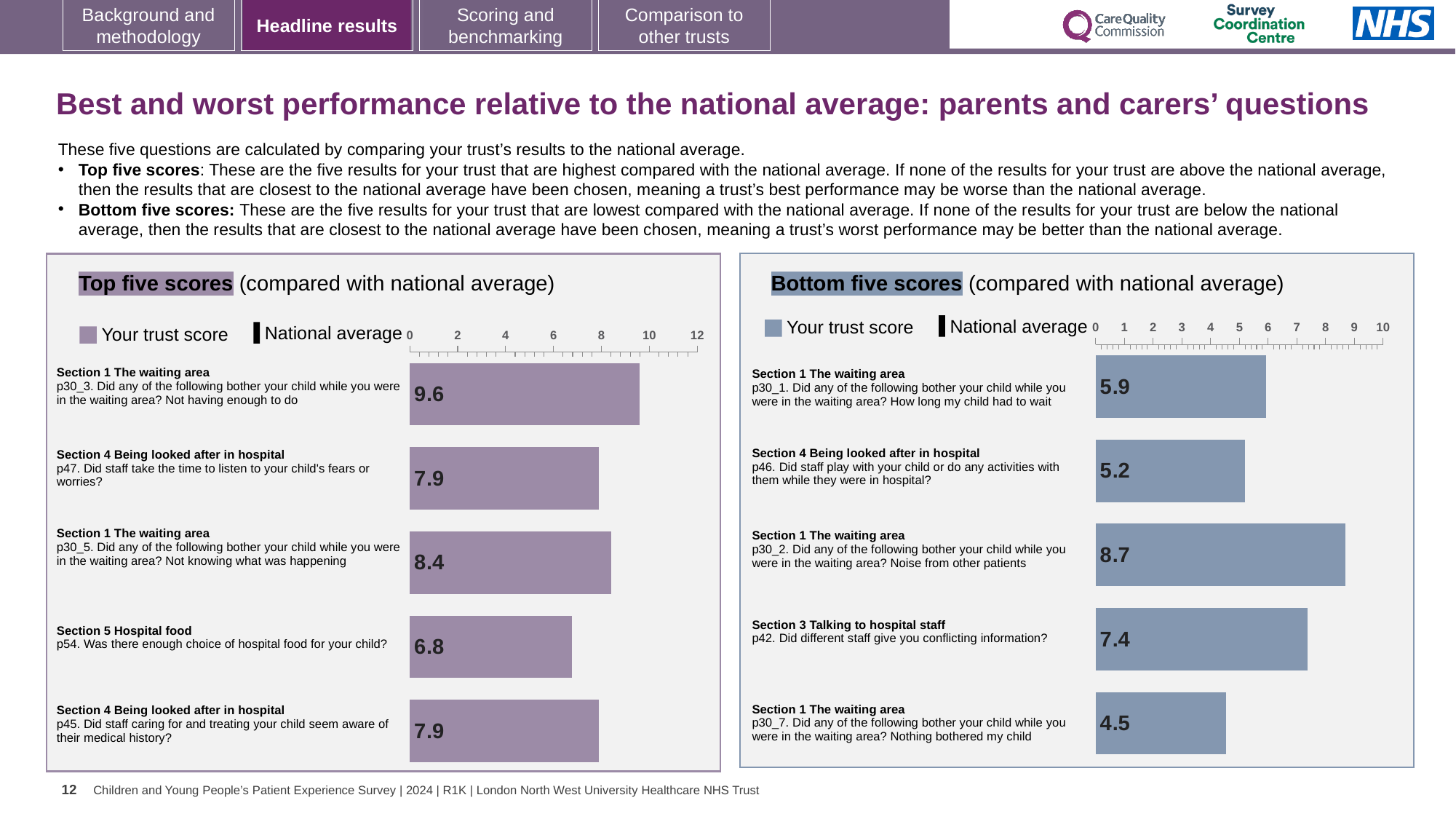
In the 'Bottom five scores' chart, which question has the highest trust score? p30_2. Noise from other patients (8.7) In the 'Bottom five scores' chart, what is the trust score for p42 (Did different staff give you conflicting information?)? 7.4 In the 'Bottom five scores' chart, is the trust score for p30_2 (Noise from other patients) greater or less than 8? greater In the 'Bottom five scores' chart, which question has the lowest trust score? p30_7. Nothing bothered my child (4.5) In the 'Top five scores' chart, what is the trust score for p30_3 (Not having enough to do in the waiting area)? 9.6 What type of chart is used for the 'Bottom five scores'? Bar chart In the 'Top five scores' chart, which question has the highest trust score? p30_3. Not having enough to do (9.6) How many questions (bars) are shown in the 'Top five scores' chart? 5 How many series does the legend of the 'Top five scores' chart list? 2 In the 'Top five scores' chart, what is the difference between the scores for p30_3 (9.6) and p54 (6.8)? 2.8 In the 'Bottom five scores' chart, which has the larger trust score: p30_1 (How long my child had to wait) or p46 (Did staff play with your child)? p30_1 (5.9) In the 'Bottom five scores' chart, what is the difference between the highest score (8.7) and the lowest score (4.5)? 4.2